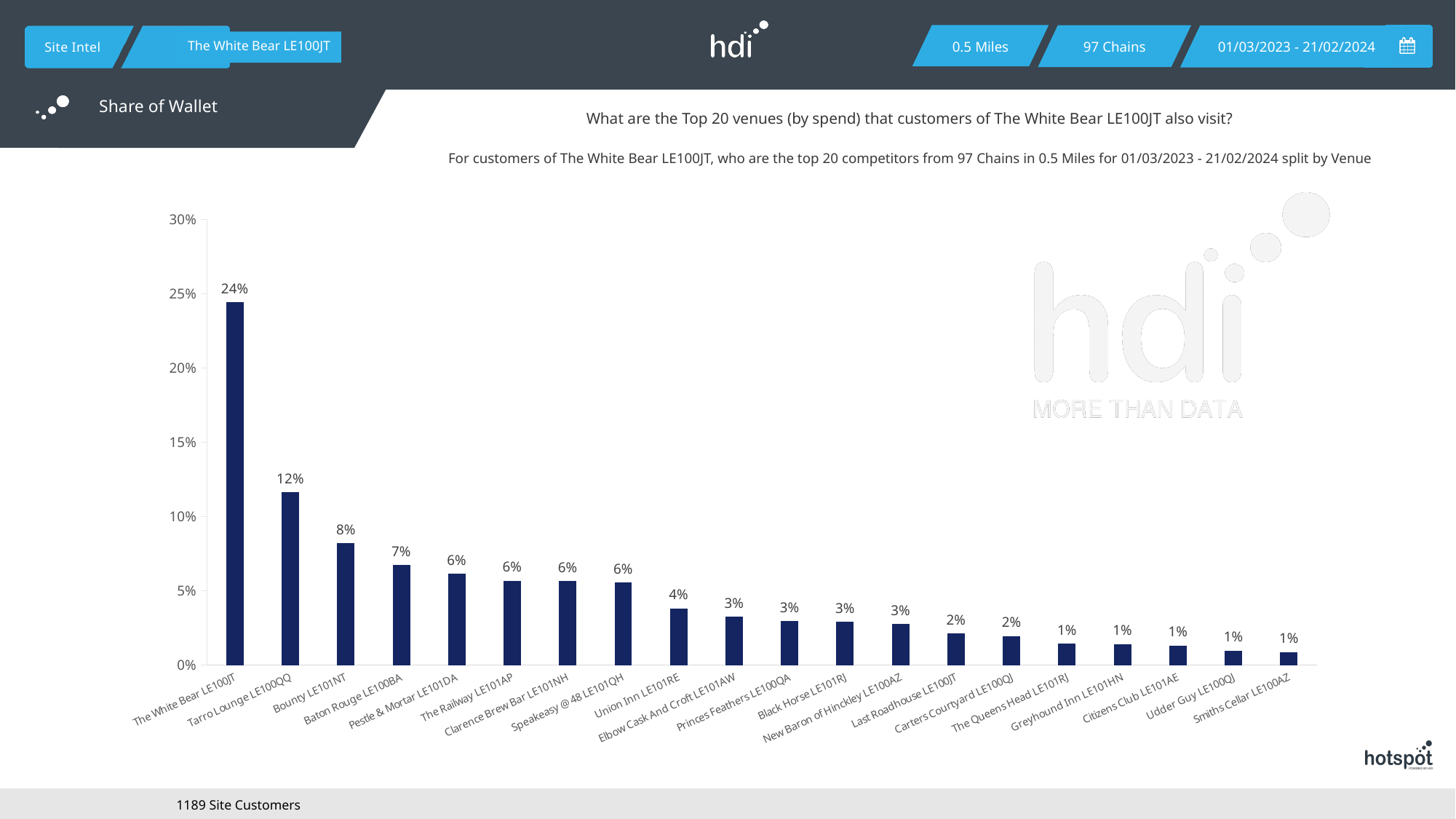
Do the values rise or fall moving from left to right along the x axis? Fall What is the value for The White Bear LE100JT? 24% What is the value for Bounty LE101NT? 8% What type of chart is shown on the slide? Bar chart Which has a larger value, Bounty LE101NT or Union Inn LE101RE? Bounty LE101NT Is the value for Tarro Lounge LE100QQ greater or less than 10%? greater What is the value for Union Inn LE101RE? 4% How many venues are plotted in the chart? 20 What is the difference between the values for The White Bear LE100JT and Tarro Lounge LE100QQ? 12% What is the value for Baton Rouge LE100BA? 7% What is the value for Tarro Lounge LE100QQ? 12% Which venue has the highest value in the chart? The White Bear LE100JT